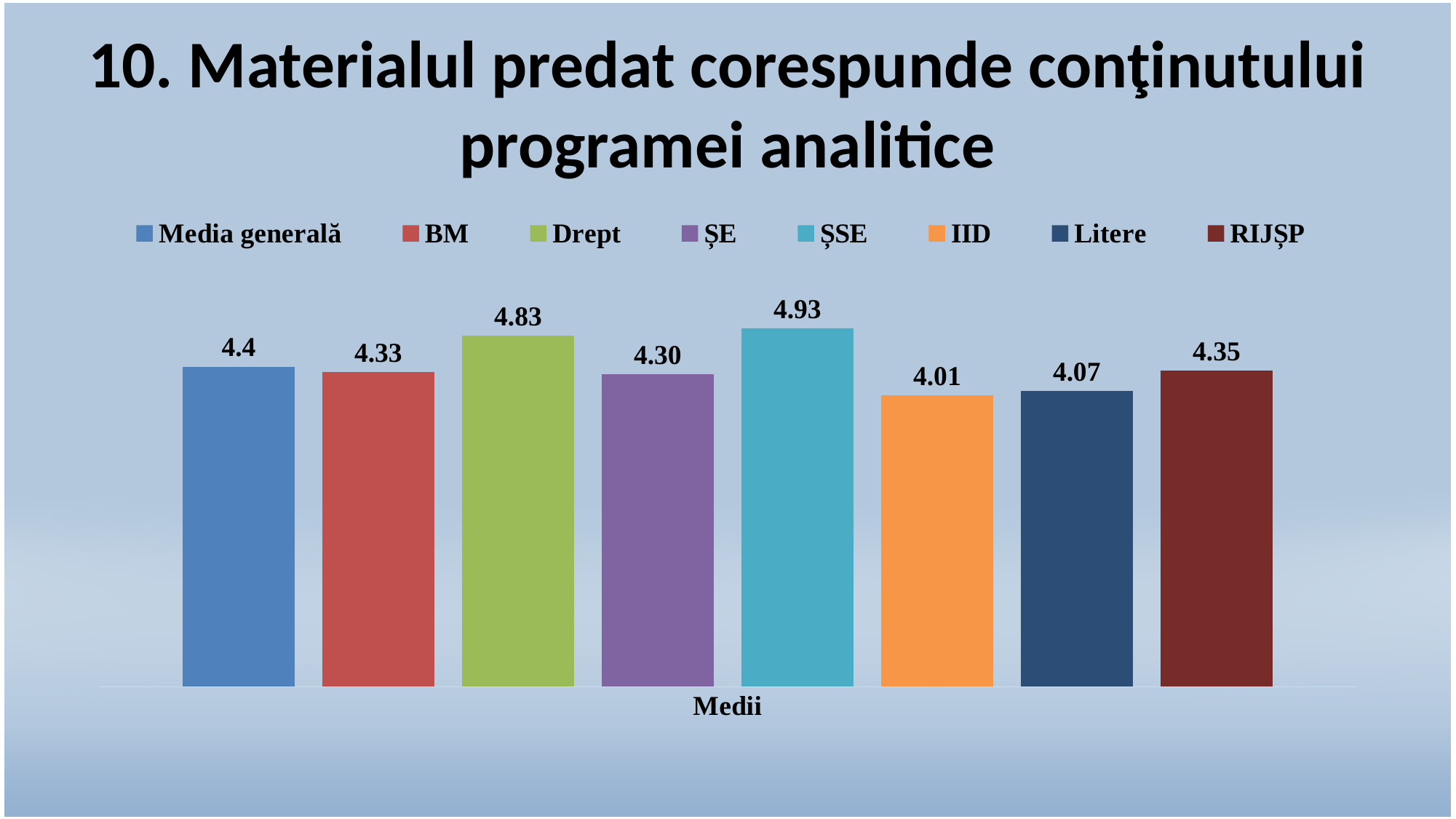
Which series has the lowest value? IID How many series does the legend list? 8 What is the value for RIJȘP? 4.35 Which series has the highest value? ȘSE What is the value for Drept? 4.83 Which is larger, the value for Drept or the value for ȘE? Drept What is the difference between the values for Drept and Litere? 0.76 What is the value for Media generală? 4.4 What is the value for IID? 4.01 What is the label on the x axis of the chart? Medii What kind of chart is shown on the slide? Bar chart What is the difference between the values for ȘSE and IID? 0.92